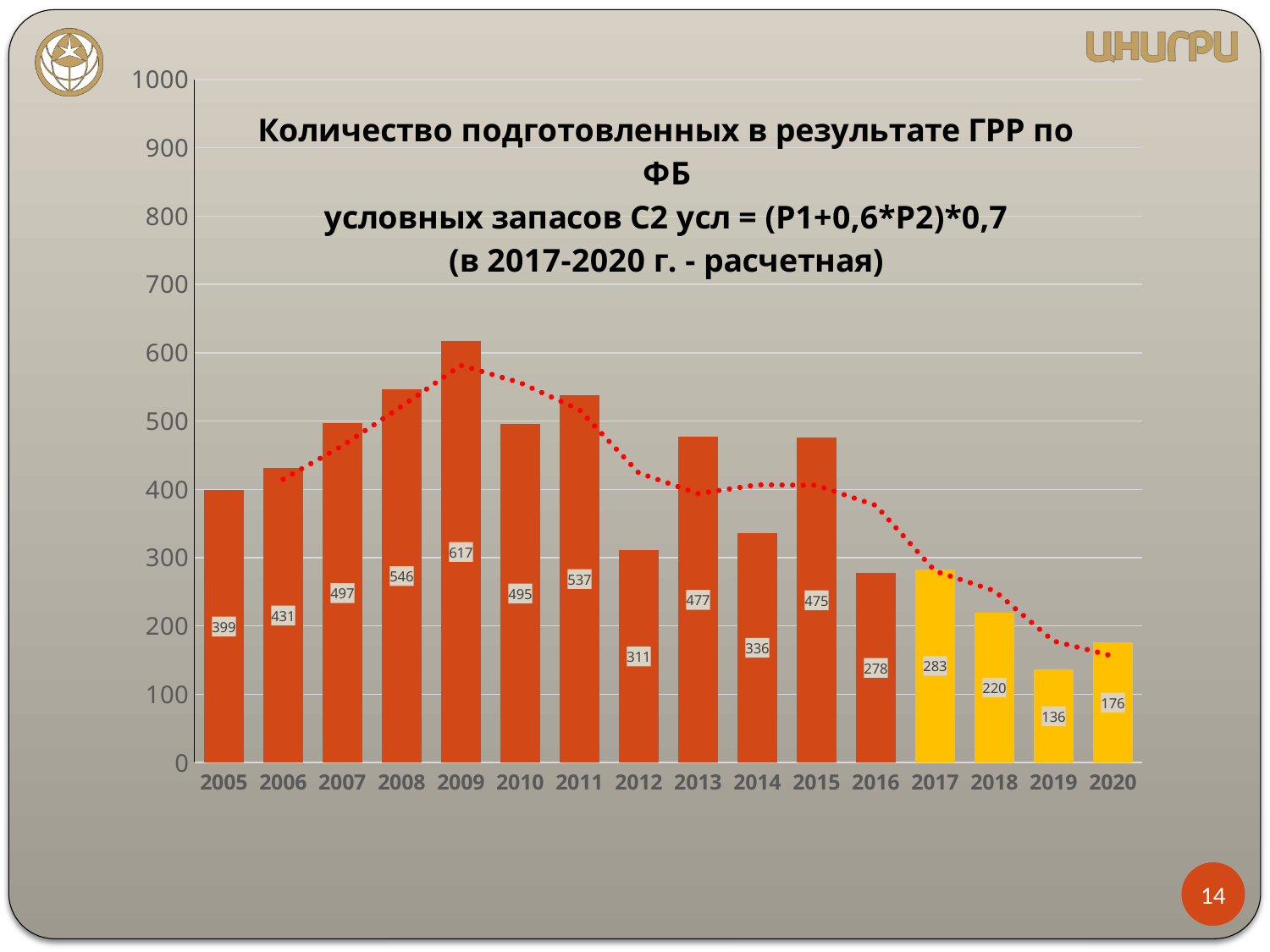
What is the value for 2009? 617 What kind of chart is shown on the slide? bar chart What is the value for 2020? 176 What is the value for 2016? 278 How many years are shown on the x axis? 16 Which year has the lowest value? 2019 Which year has the highest value? 2009 What is the difference between the values for 2009 and 2019? 481 What is the difference between the values for 2017 and 2016? 5 Which is larger, the value for 2011 or the value for 2012? 2011 Is the value for 2012 greater or less than 400? less Do the values rise or fall from 2005 to 2009? rise